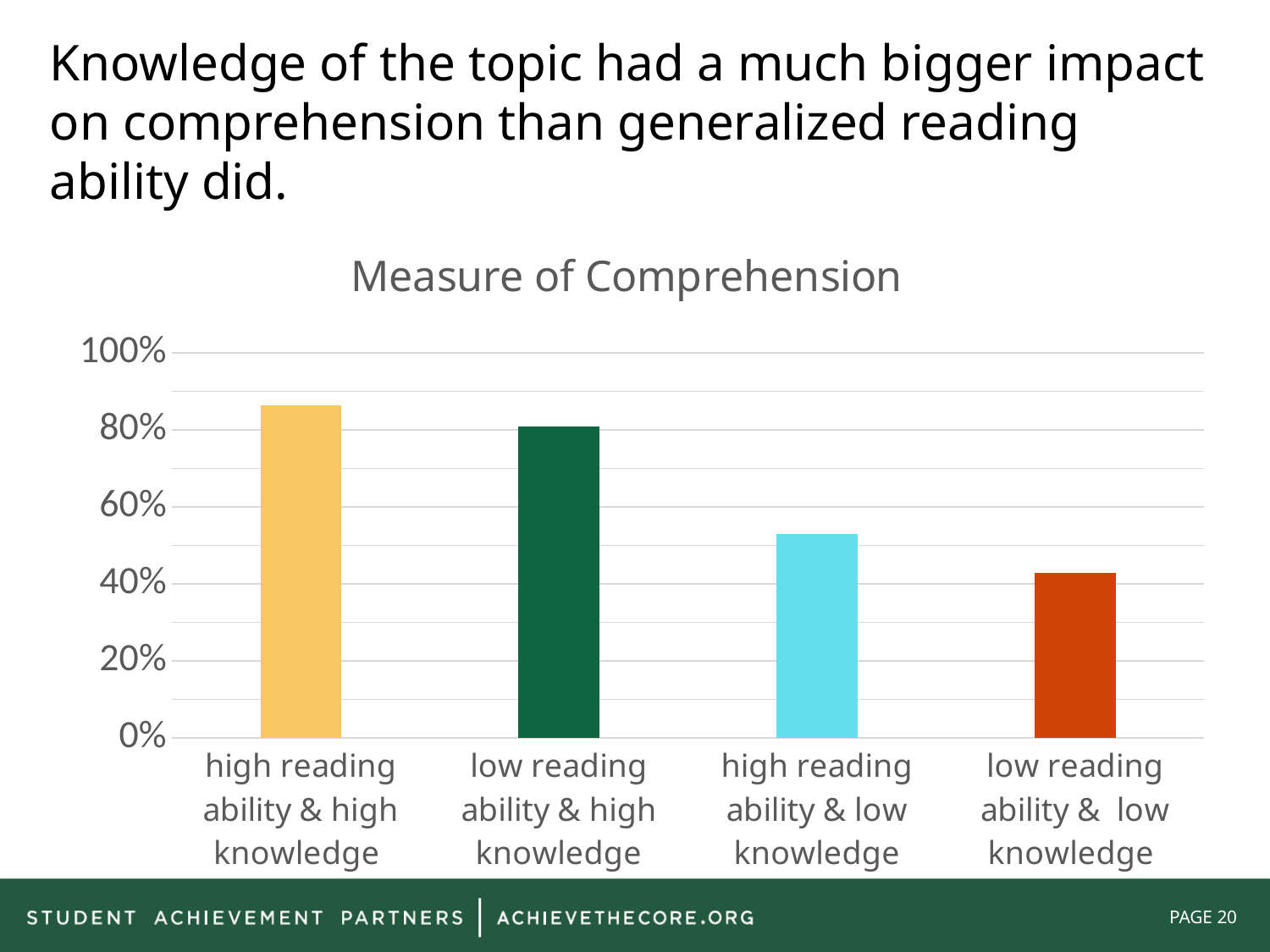
Do the values rise or fall from left to right across the categories? fall What kind of chart is shown on the slide? bar chart Which category has the highest value? high reading ability & high knowledge What is the title of the chart? Measure of Comprehension Is the value for low reading ability & low knowledge greater or less than 60%? less How many categories are plotted in the chart? 4 Which category has the lowest value? low reading ability & low knowledge Is the value for high reading ability & low knowledge greater or less than 60%? less Is the value for low reading ability & high knowledge greater or less than 60%? greater Which is larger: the value for low reading ability & high knowledge or the value for high reading ability & low knowledge? low reading ability & high knowledge What colour is the bar for high reading ability & low knowledge? light blue